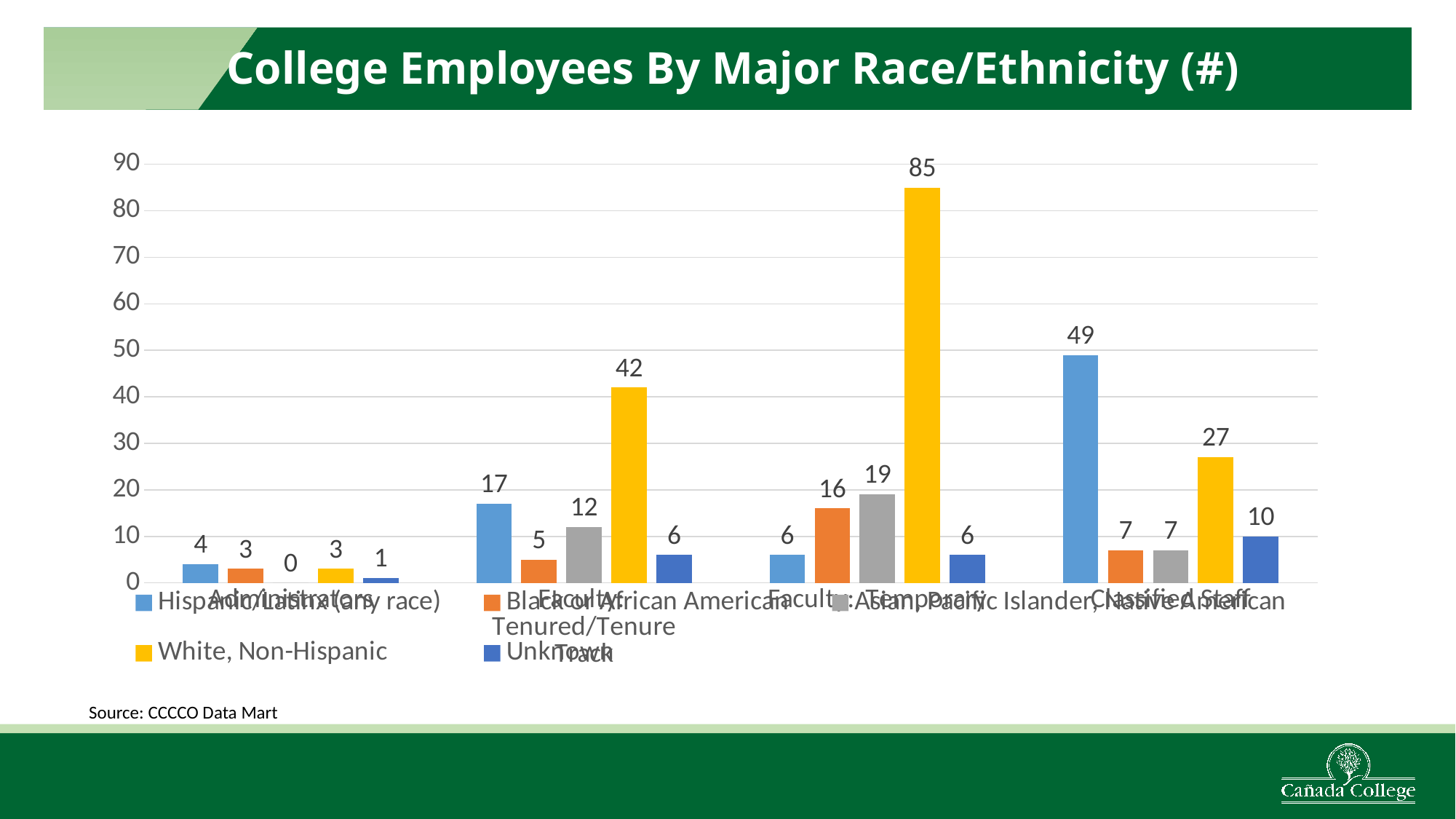
What is the value for Unknown in the Faculty: Tenured/Tenure Track category? 6 What kind of chart is shown on the slide? Bar chart What is the difference between the White, Non-Hispanic values for Faculty: Temporary and Faculty: Tenured/Tenure Track? 43 What is the value for Hispanic/Latinx (any race) employees in the Classified Staff category? 49 Which series has the highest value in the Faculty: Tenured/Tenure Track category? White, Non-Hispanic Which series has the lowest value in the Classified Staff category? Black or African American and Asian, Pacific Islander, Native American (tied at 7) What is the value for White, Non-Hispanic employees in the Faculty: Temporary category? 85 How many categories are shown on the x axis? 4 Which is larger: the Black or African American value for Faculty: Temporary or the Asian, Pacific Islander, Native American value for Faculty: Temporary? Asian, Pacific Islander, Native American What is the title of the chart? College Employees By Major Race/Ethnicity (#) How many series does the legend list? 5 What is the value for Asian, Pacific Islander, Native American employees in the Administrators category? 0